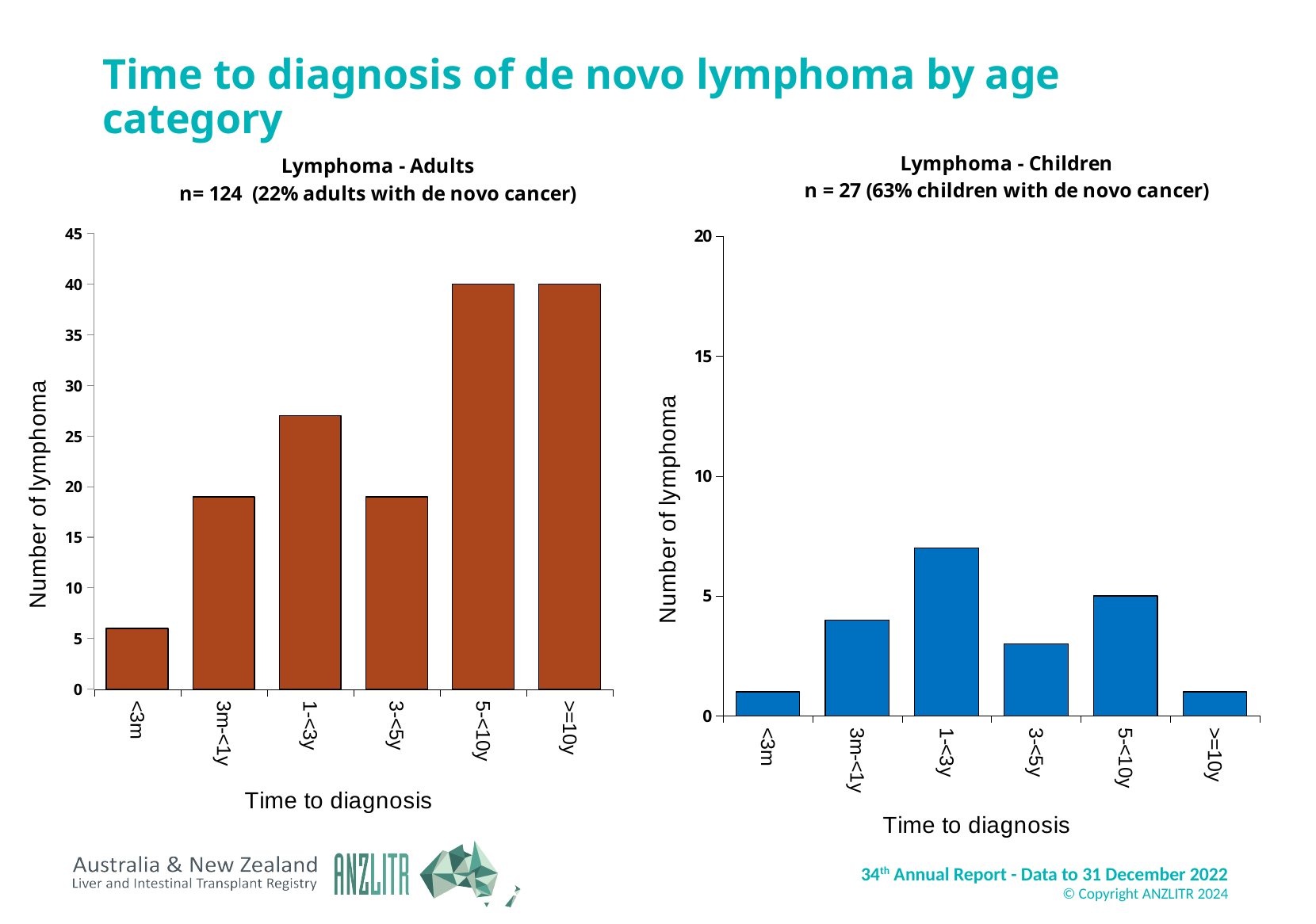
In the Lymphoma - Children chart, which has a higher number of lymphoma: 3m-<1y or 3-<5y? 3m-<1y In the Lymphoma - Children chart, what is the number of lymphoma for the 5-<10y category? 5 In the Lymphoma - Adults chart, which time to diagnosis category has the lowest number of lymphoma? <3m In the Lymphoma - Adults chart, what is the number of lymphoma for the >=10y category? 40 In the Lymphoma - Children chart, is the value for 1-<3y greater or less than 5? greater How many time to diagnosis categories are shown in the Lymphoma - Children chart? 6 In the Lymphoma - Children chart, which time to diagnosis category has the highest number of lymphoma? 1-<3y In the Lymphoma - Adults chart, is the value for <3m greater or less than 10? less In the Lymphoma - Adults chart, what is the number of lymphoma for the 5-<10y time to diagnosis category? 40 In the Lymphoma - Adults chart, is the value for 1-<3y greater or less than 25? greater What type of chart is the Lymphoma - Adults chart? Bar chart In the Lymphoma - Adults chart, which has a higher number of lymphoma: 1-<3y or 3-<5y? 1-<3y